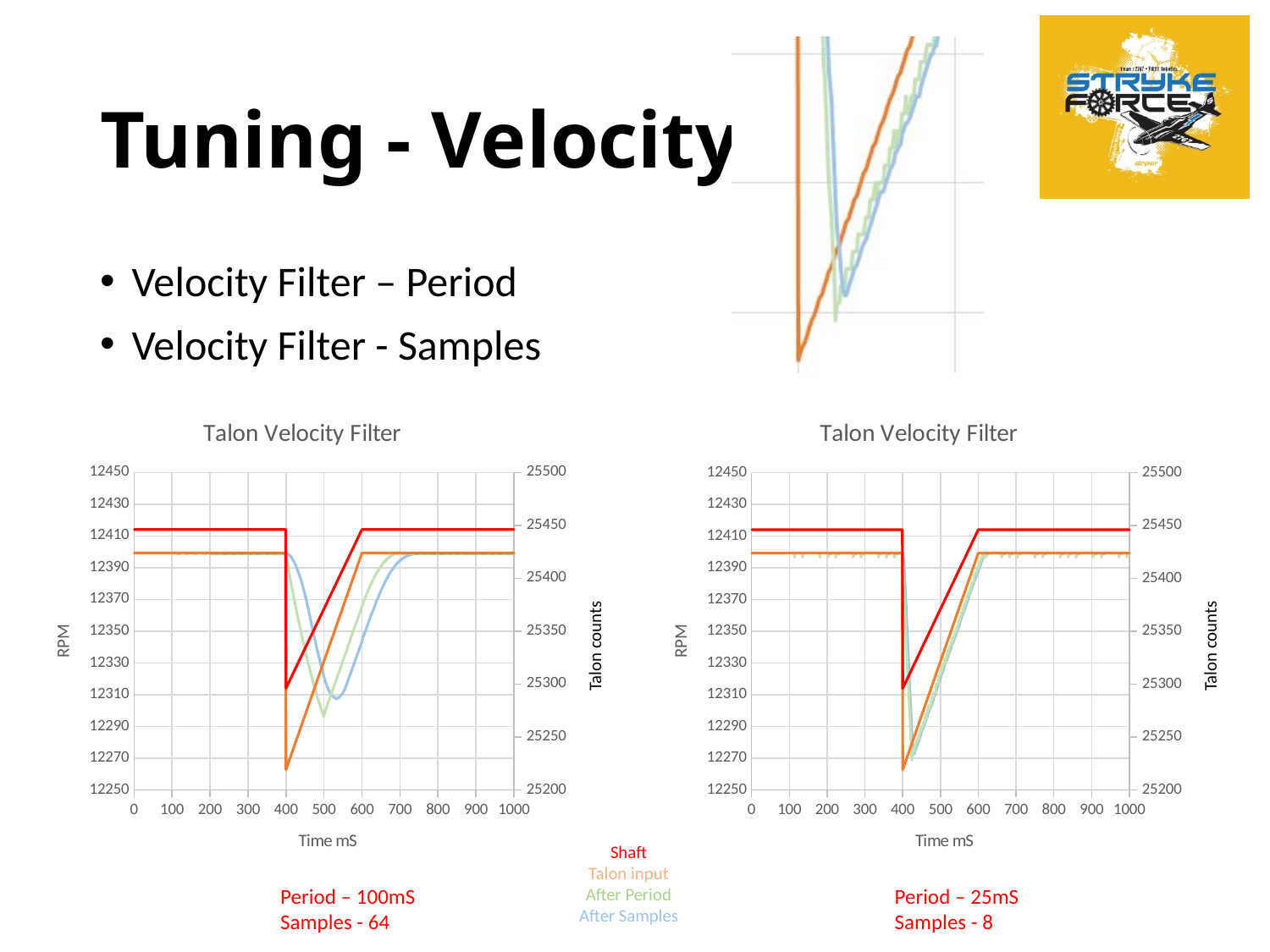
In the right chart, does the Shaft line rise or fall between 400 ms and 600 ms? rises In the left chart, is the lowest value of the Shaft line greater or less than 12330 RPM? less What is the label of the right-hand vertical axis on the right chart? Talon counts How many series does the legend between the two charts list? 4 What is the x-axis label of the left chart? Time mS In the right chart, is the Shaft line's value at 0 ms greater or less than 12390 RPM? greater In the left chart, which series reaches the lowest value? Talon input In the left chart, does the Talon input line rise or fall between 400 ms and 500 ms? rises In the left chart, at 500 ms, which is higher: the Shaft line or the Talon input line? Shaft What kind of chart is the left 'Talon Velocity Filter' chart? line chart How many tick labels are shown on the x axis of the right chart? 11